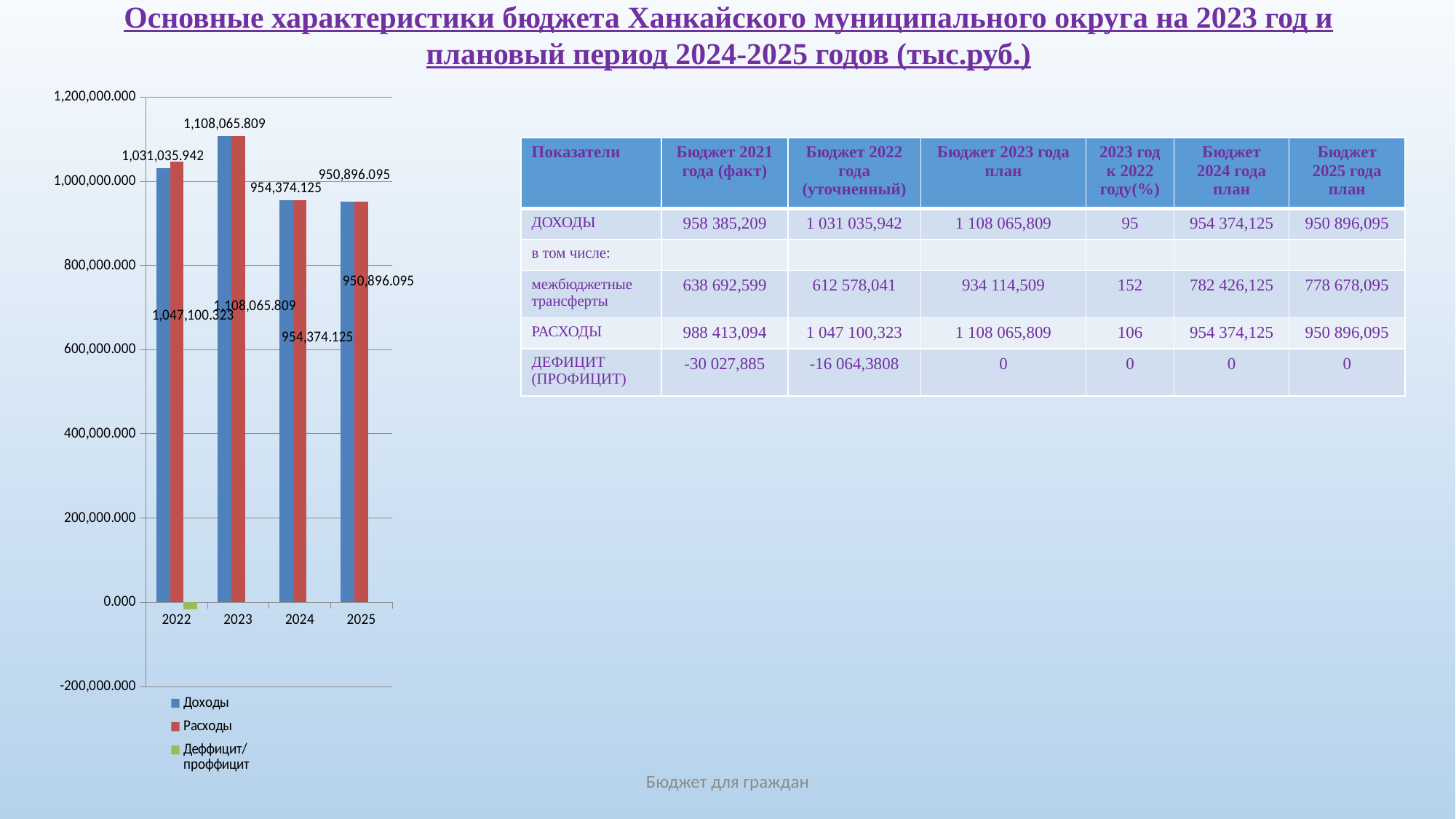
In which year is Доходы highest in the chart? 2023 Do the Доходы values rise or fall from 2023 to 2025 in the chart? fall Is the value of Доходы for 2024 greater or less than 1,000,000.000? less What is the value of Доходы for 2025 in the chart? 950,896.095 What is the value of Доходы for 2022 in the chart? 1,031,035.942 In which year is Расходы lowest in the chart? 2025 What type of chart is shown on the slide? bar chart What is the value of Расходы for 2022 in the chart? 1,047,100.323 How many series does the chart legend list? 3 What is the difference between Расходы and Доходы for 2022 in the chart? 16,064.381 Which is larger in the chart: Доходы for 2023 or Доходы for 2025? Доходы for 2023 How many years are shown on the x axis of the chart? 4